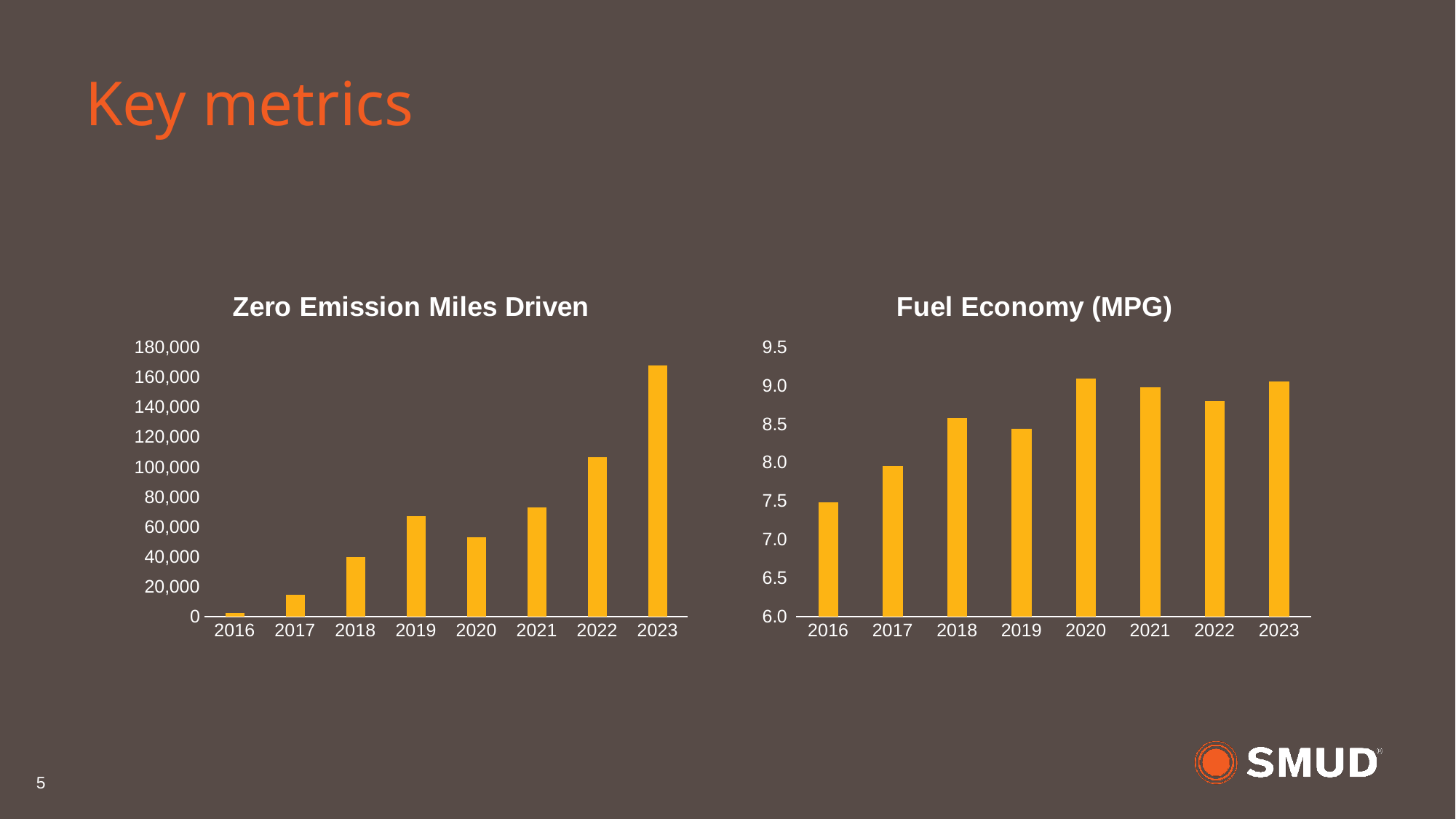
What is the title of the chart on the right side of the slide? Fuel Economy (MPG) In the Zero Emission Miles Driven chart, which is larger, the value for 2019 or the value for 2020? 2019 In the Zero Emission Miles Driven chart, which year has the lowest value? 2016 In the Fuel Economy (MPG) chart, which year has the lowest value? 2016 In the Zero Emission Miles Driven chart, is the value for 2023 greater or less than 160,000? greater In the Zero Emission Miles Driven chart, which year has the highest value? 2023 In the Fuel Economy (MPG) chart, is the value for 2022 greater or less than 9.0? less What kind of chart is the Zero Emission Miles Driven chart? bar chart How many years are shown on the Fuel Economy (MPG) chart? 8 In the Fuel Economy (MPG) chart, which is larger, the value for 2020 or the value for 2022? 2020 In the Zero Emission Miles Driven chart, is the value for 2020 greater or less than 60,000? less